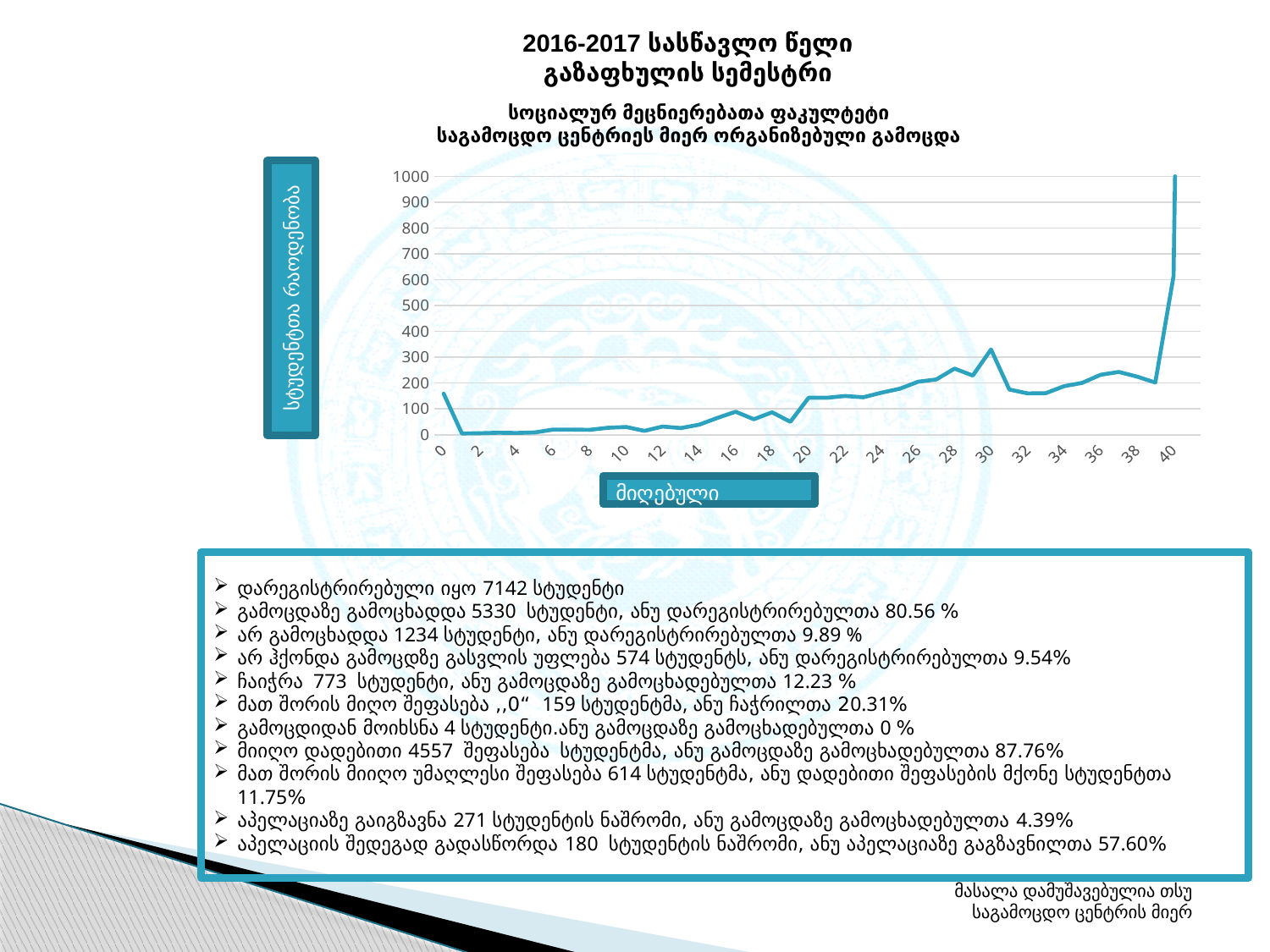
Is the value at x = 20 greater or less than 100? greater What kind of chart is shown on the slide? line chart Is the value at x = 10 greater or less than 100? less Is the value at x = 30 greater or less than 200? greater Overall, do the values rise or fall as x increases from 2 to 40? rise Which is larger, the value at x = 30 or the value at x = 20? x = 30 How many series does the chart legend list? 1 What is the label on the vertical axis of the chart? სტუდენტთა რაოდენობა What is the legend entry of the plotted series? მიღებული At which x-axis value does the line reach its highest point? 40